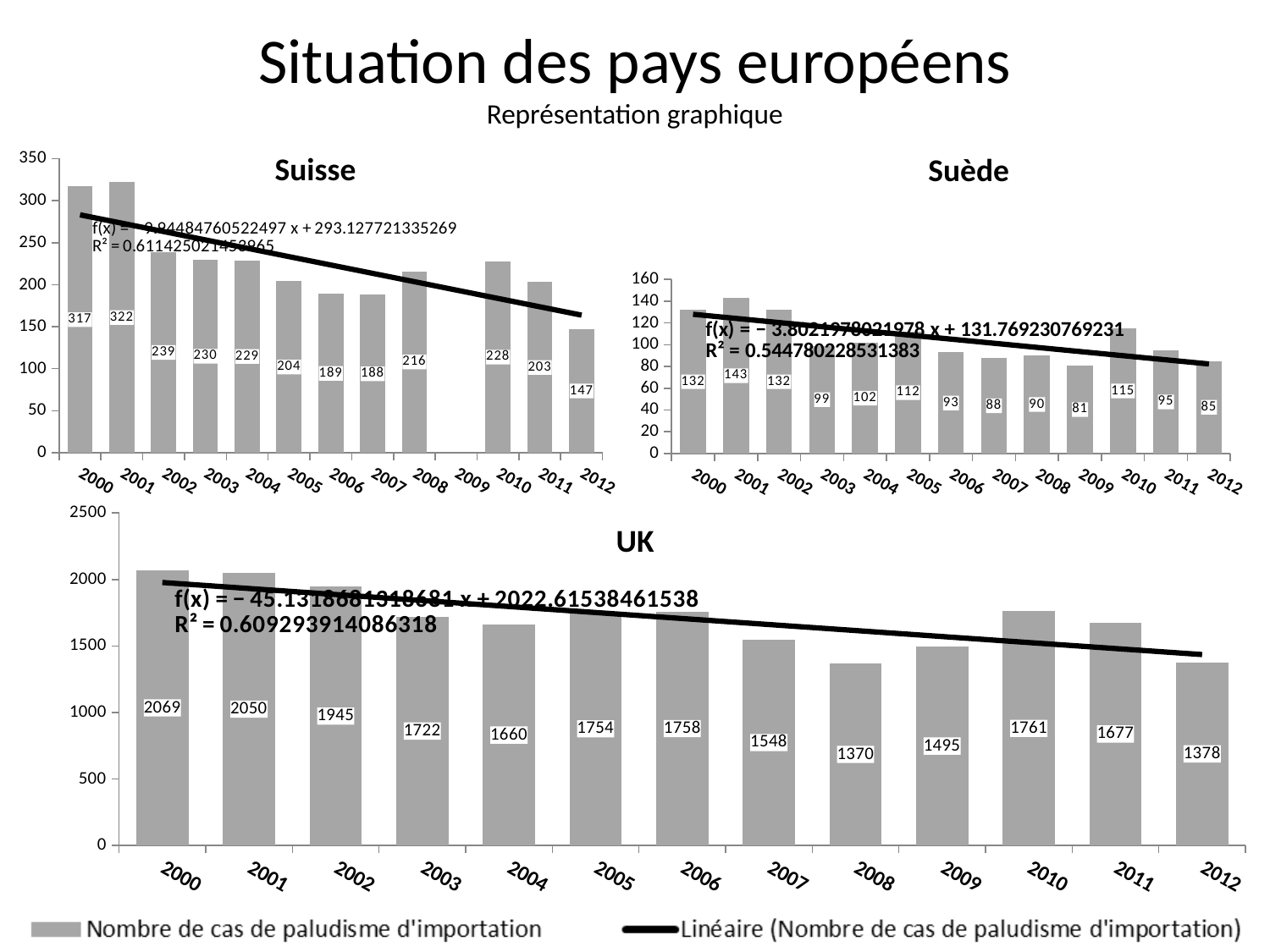
In the UK chart, what is the value for 2008? 1370 In the UK chart, do the values generally rise or fall from 2000 to 2012? fall What kind of chart is the UK chart? bar chart In the UK chart, what is the difference between the values for 2000 and 2012? 691 In the Suède chart, what is the value for 2009? 81 In the UK chart, which year has the highest value? 2000 In the Suisse chart, which is larger, the value for 2008 or the value for 2011? 2008 In the Suède chart, what is the difference between the values for 2001 and 2009? 62 In the Suisse chart, which year has the lowest value among the plotted bars? 2012 In the Suède chart, which year has the highest value? 2001 In the UK chart, is the value for 2010 greater or less than 1500? greater In the Suisse chart, what is the value for 2001? 322